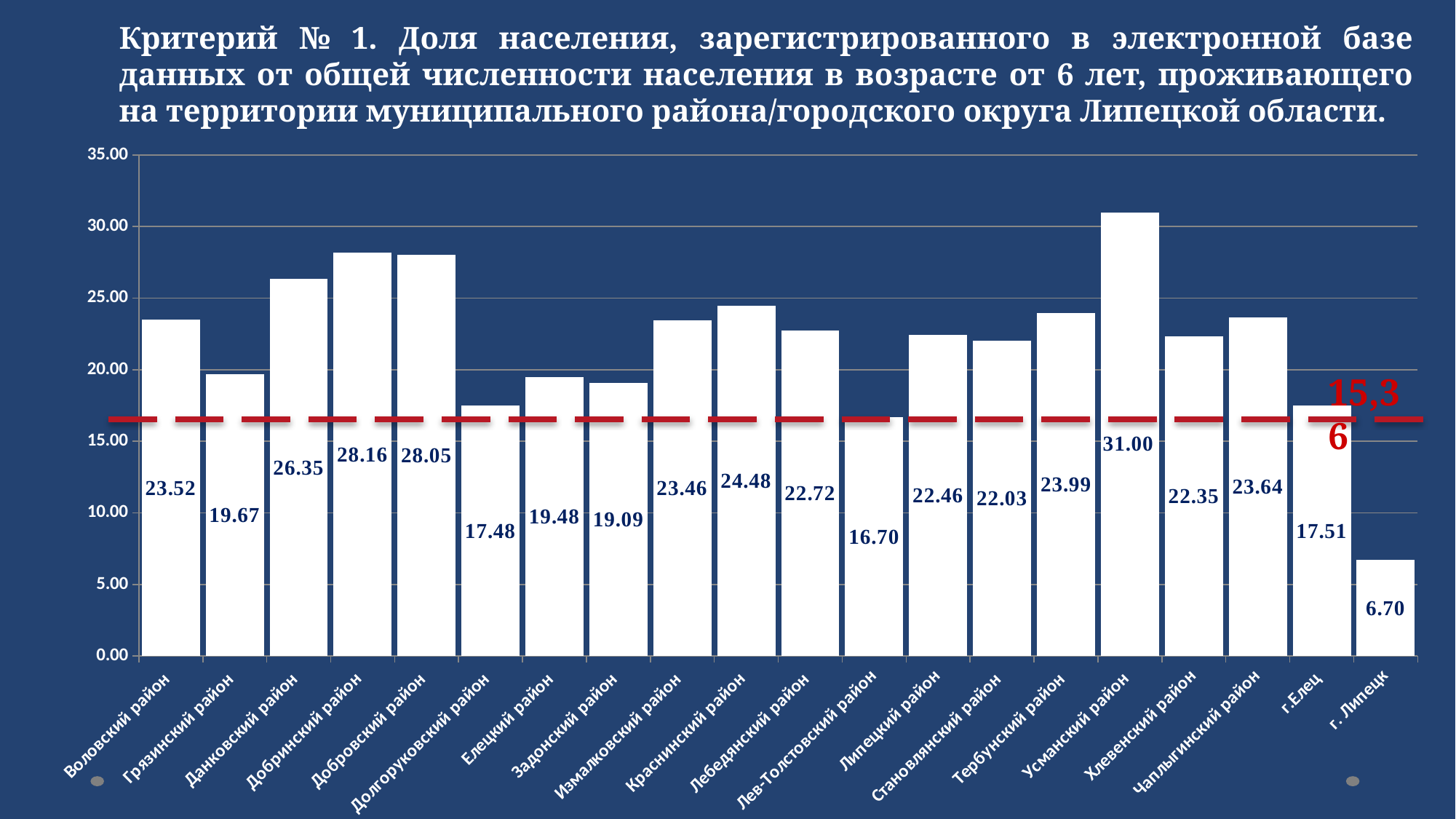
Which category has the lowest value? г. Липецк What value is labelled on the red dashed horizontal line? 15,36 What is the difference between the values for Усманский район and г. Липецк? 24.30 Is the value for Усманский район greater or less than 30.00? greater What kind of chart is shown on the slide? Bar chart Which is larger, the value for Данковский район or the value for Краснинский район? Данковский район Which category has the highest value? Усманский район What is the value for г. Липецк? 6.70 What is the value for Усманский район? 31.00 What is the difference between the values for Добринский район and Добровский район? 0.11 How many categories are shown on the x axis? 20 What is the value for Лев-Толстовский район? 16.70